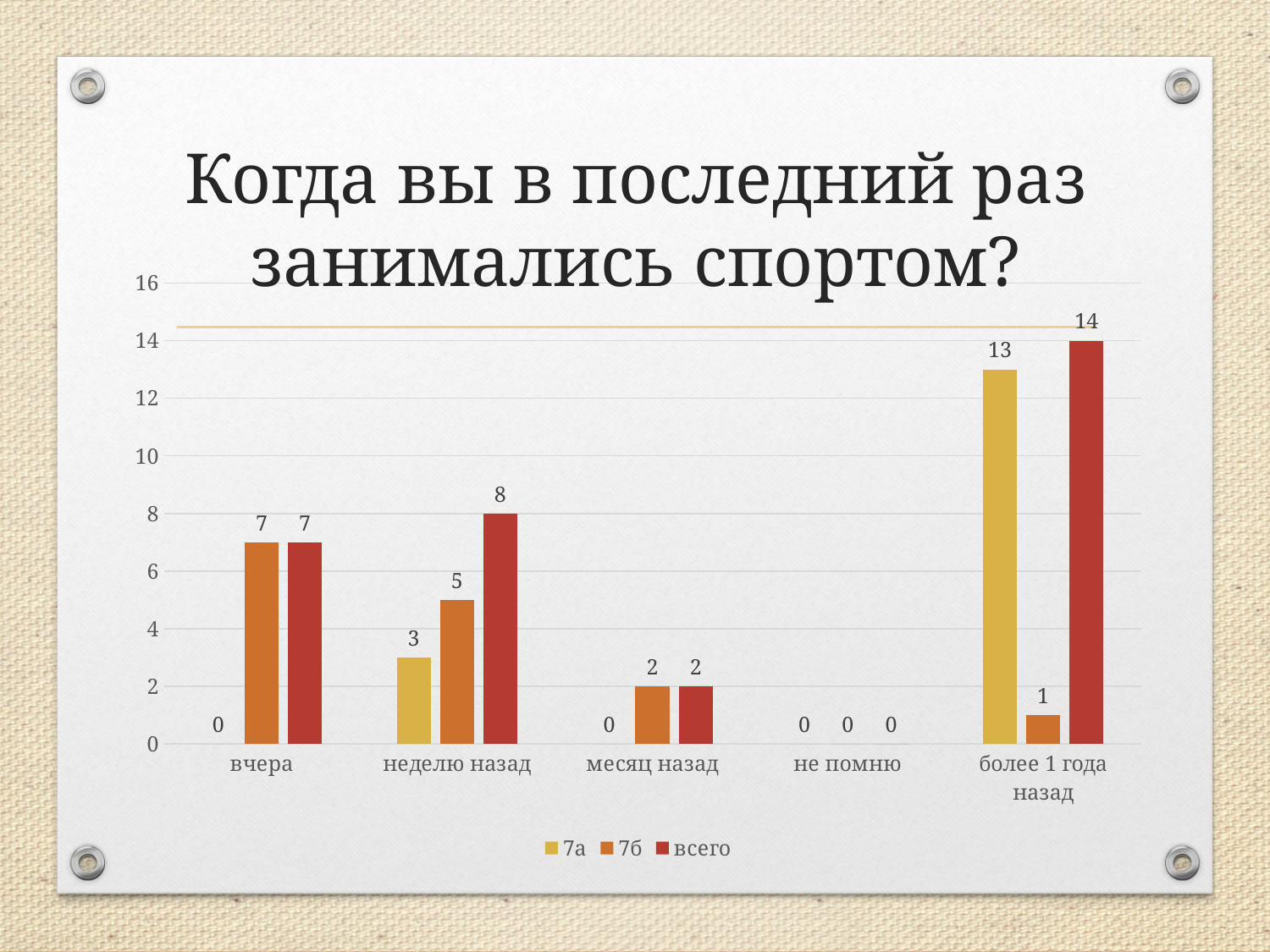
How many series does the legend list? 3 Which category has the highest value for the 'всего' series? более 1 года назад What is the value for '7а' in the 'неделю назад' category? 3 What is the title of the chart? Когда вы в последний раз занимались спортом? How many categories are shown on the x axis? 5 Which is larger in the 'неделю назад' category: the value for '7а' or for '7б'? 7б What kind of chart is shown on the slide? bar chart What is the difference between the '7а' and '7б' values in the 'более 1 года назад' category? 12 What is the value for 'всего' in the 'более 1 года назад' category? 14 Which category has the lowest value for the '7б' series? не помню Is the value for 'всего' in the 'более 1 года назад' category greater or less than 10? greater What is the value for '7б' in the 'вчера' category? 7